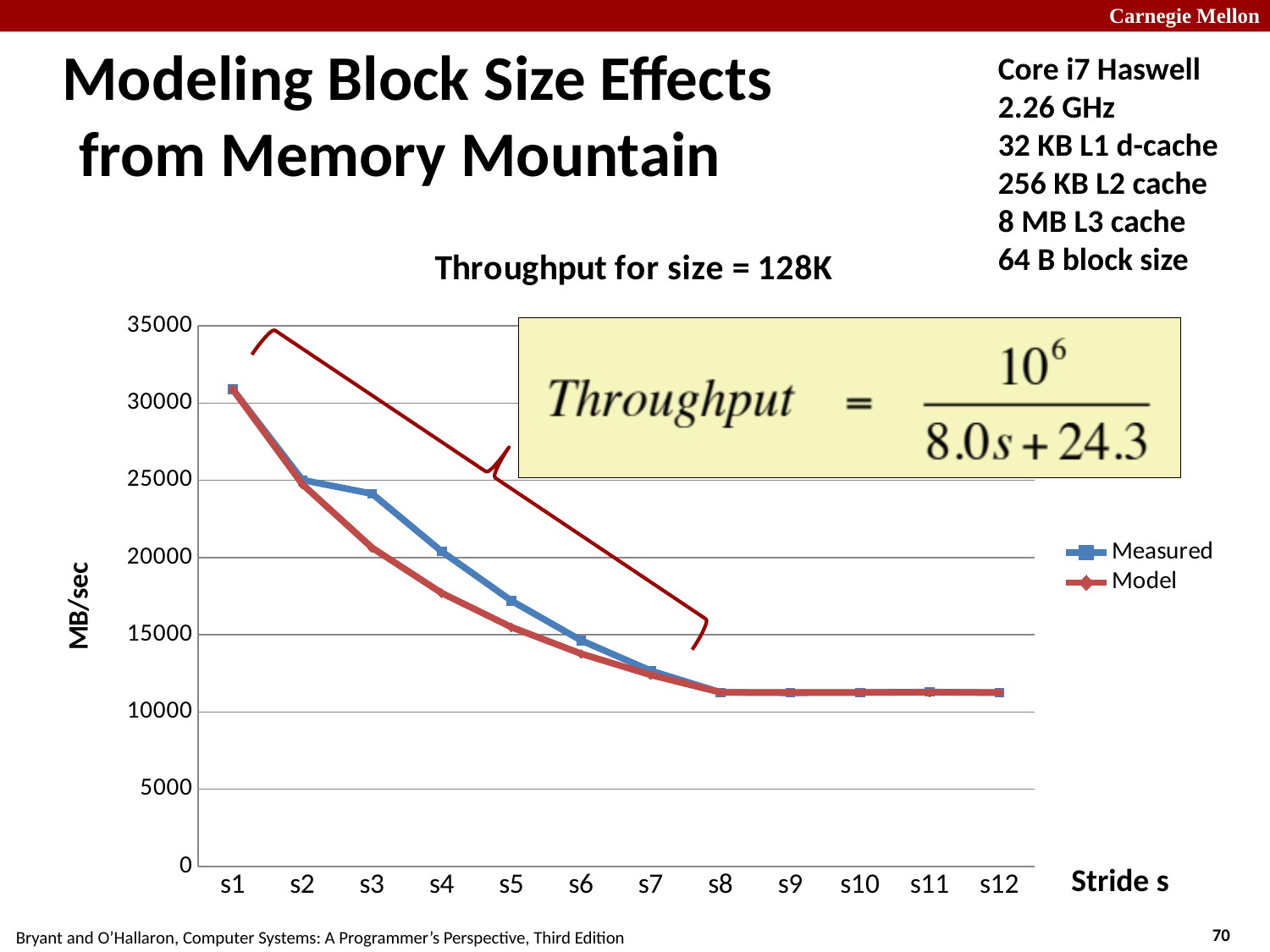
Is the Model value at s6 greater or less than 15000? less Is the Measured value at s5 greater or less than 15000? greater At which stride is the Model throughput highest? s1 How many series does the legend list? 2 At which stride is the Measured throughput highest? s1 What kind of chart is shown on the slide? line chart How many stride values are plotted along the x axis? 12 What is the label on the y axis? MB/sec What is the title of the chart? Throughput for size = 128K At stride s3, which series has the larger value, Measured or Model? Measured Do the Measured values rise or fall as the stride increases from s1 to s8? fall Is the Measured value at s3 greater or less than 25000? less